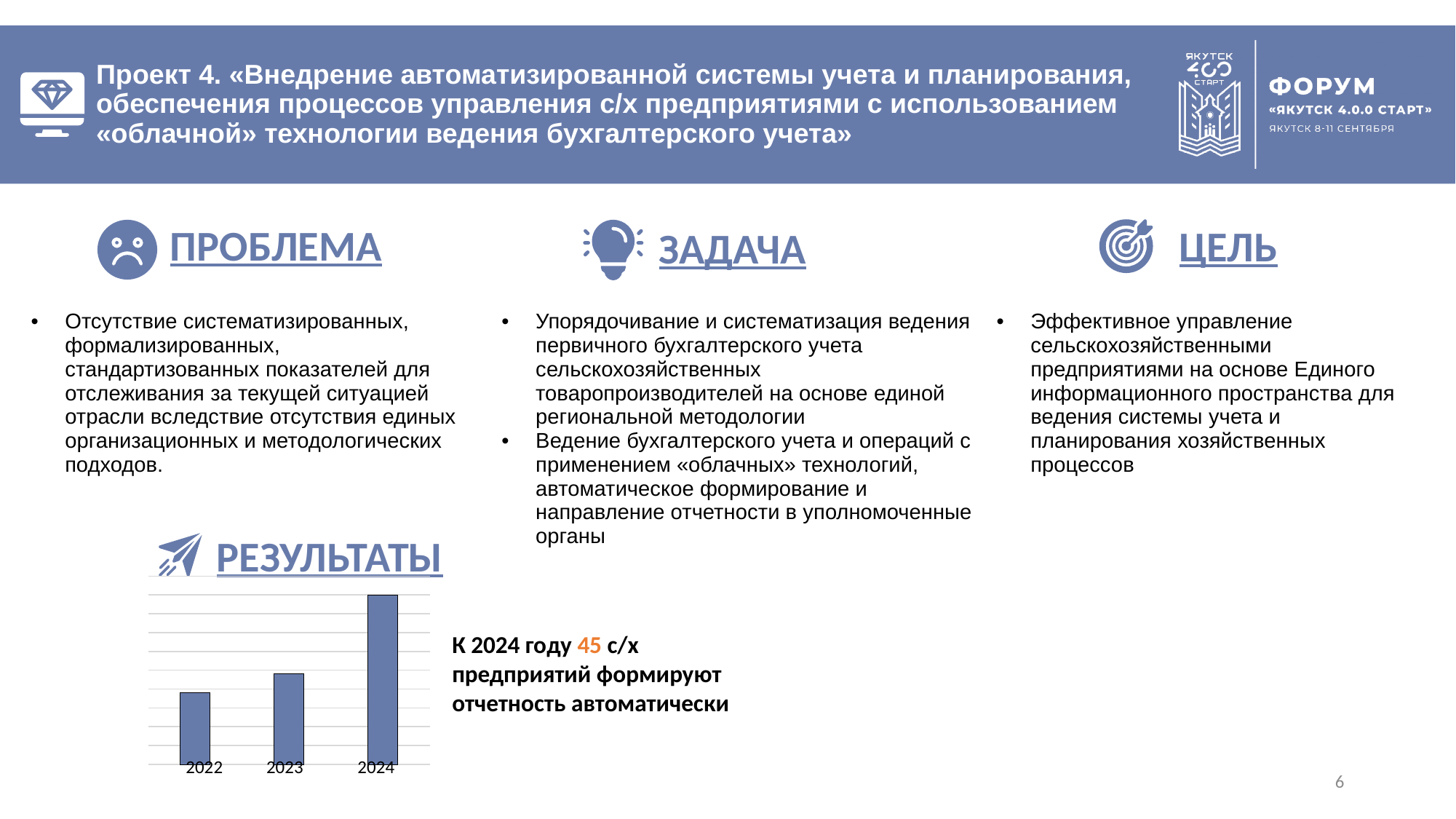
What is the first year shown on the x axis of the chart under «РЕЗУЛЬТАТЫ»? 2022 What are the category labels on the x axis of the chart under «РЕЗУЛЬТАТЫ»? 2022, 2023, 2024 How many bars (categories) does the chart under «РЕЗУЛЬТАТЫ» have? 3 In the chart under «РЕЗУЛЬТАТЫ», which bar is taller: 2022 or 2023? 2023 In the chart under «РЕЗУЛЬТАТЫ», which bar is taller: 2023 or 2024? 2024 Which year has the shortest bar in the chart under «РЕЗУЛЬТАТЫ»? 2022 Do the bar values in the chart under «РЕЗУЛЬТАТЫ» rise or fall from 2022 to 2024? rise Which year has the tallest bar in the chart under «РЕЗУЛЬТАТЫ»? 2024 What kind of chart is shown under the heading «РЕЗУЛЬТАТЫ»? bar chart